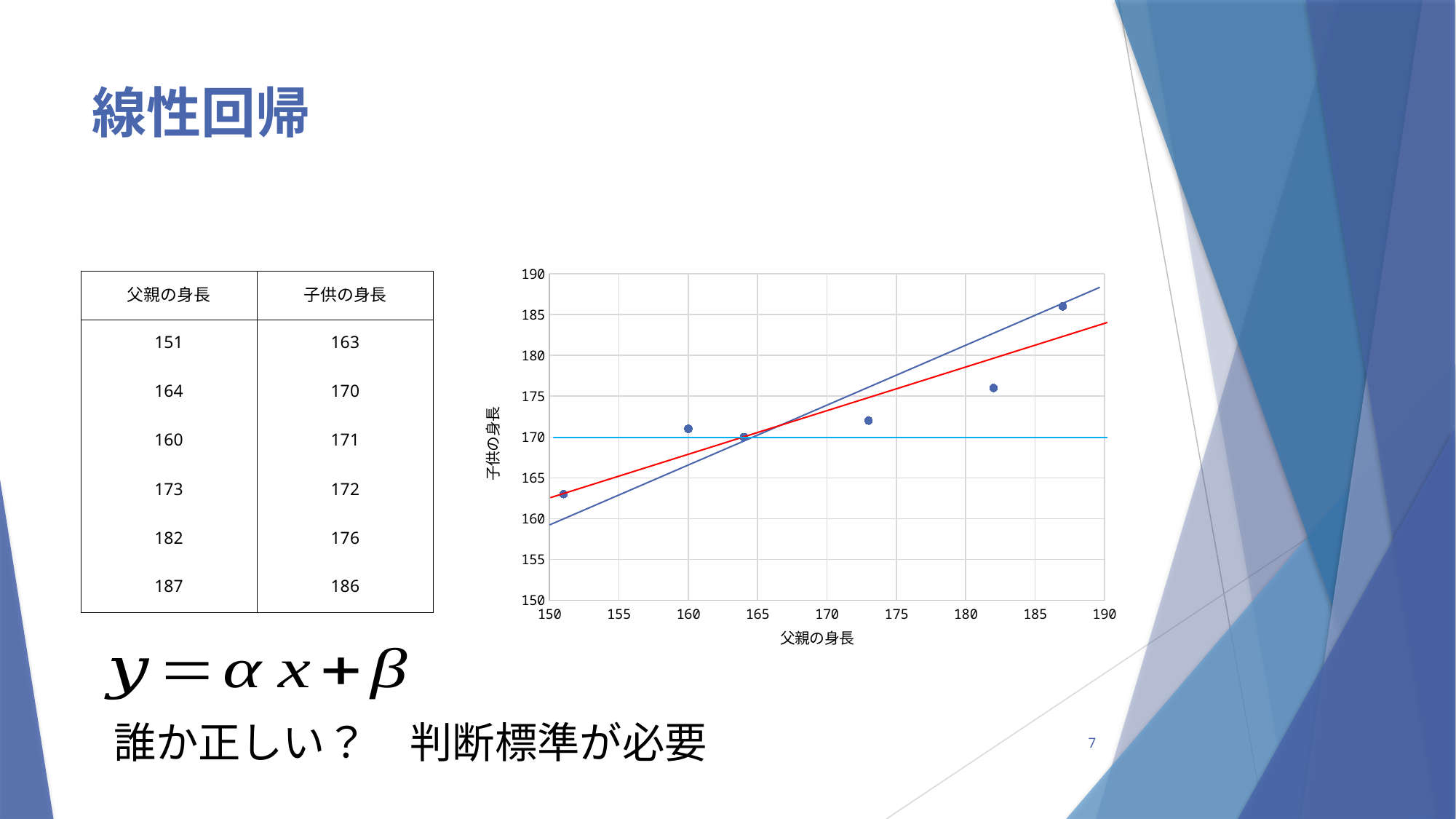
What is the child's height (子供の身長) for the father's height of 187? 186 How many data points are plotted in the chart? 6 Do the child's height values generally rise or fall as the father's height increases along the x axis? rise Which father's height (父親の身長) corresponds to the highest child's height (子供の身長) in the chart? 187 Which father's height (父親の身長) corresponds to the lowest child's height (子供の身長) in the chart? 151 What is the title of the x axis of the chart? 父親の身長 Is the child's height for the father's height of 182 greater or less than 180? less What kind of chart is shown on the slide? scatter chart What is the difference between the child's height for the father's height of 187 and the child's height for the father's height of 151? 23 Is the child's height for the father's height of 160 greater or less than 165? greater At what y value does the horizontal light blue line in the chart lie? 170 Which has the higher child's height: the point for father's height 173 or the point for father's height 182? 182